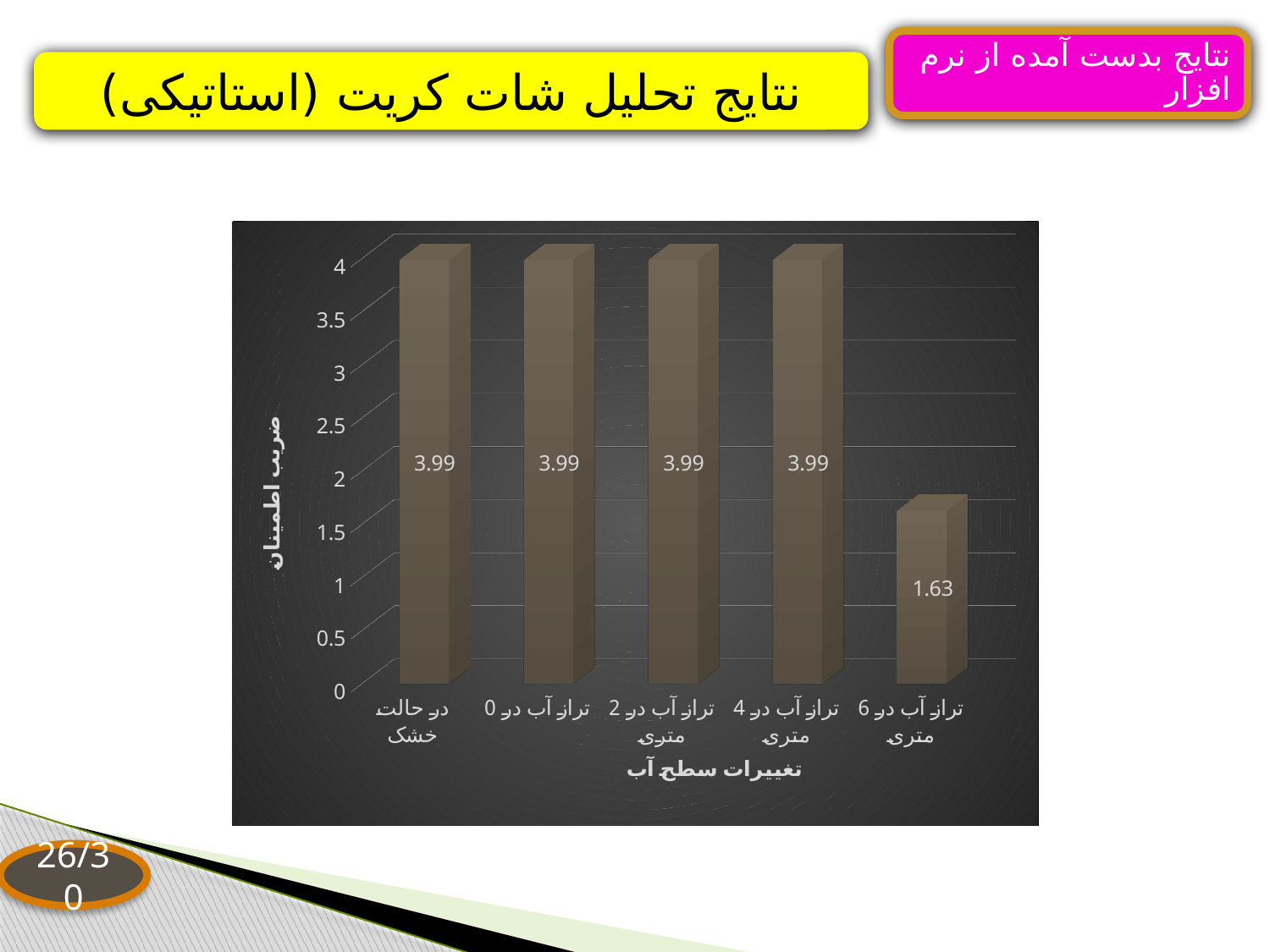
Which category has the lowest value in the chart? تراز آب در 6 متری What is the label of the vertical (y) axis of the chart? ضریب اطمینان What kind of chart is shown on the slide? bar chart How many categories are shown on the x axis of the chart? 5 What is the value shown for "تراز آب در 2 متری"? 3.99 What is the safety factor (ضریب اطمینان) value for the category "در حالت خشک"? 3.99 What is the value shown for "تراز آب در 6 متری"? 1.63 What is the label of the horizontal (x) axis of the chart? تغییرات سطح آب How many categories have a value of 3.99? 4 Which is larger: the value for "تراز آب در 0 متری" or the value for "تراز آب در 6 متری"? تراز آب در 0 Is the value for "تراز آب در 6 متری" greater or less than 2? less What is the difference between the value for "تراز آب در 4 متری" and the value for "تراز آب در 6 متری"? 2.36